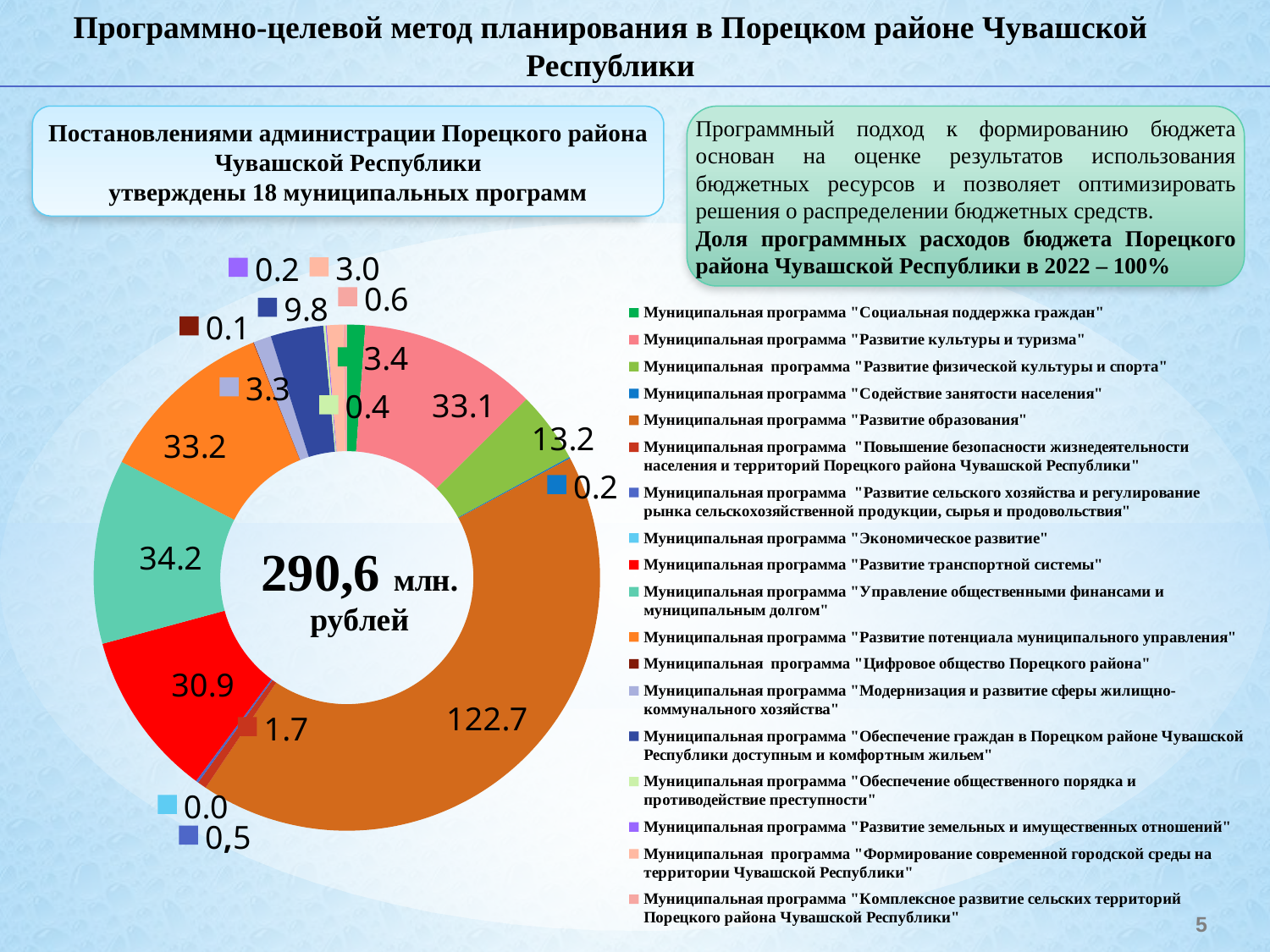
What is the value shown for the programme "Обеспечение граждан в Порецком районе Чувашской Республики доступным и комфортным жильем" (navy segment)? 9.8 How many municipal programmes are listed in the chart legend? 18 What is the value shown for the programme "Развитие транспортной системы" (red segment)? 30.9 What is the value shown for the programme "Развитие культуры и туризма" (pink segment)? 33.1 What kind of chart is shown on the slide? Doughnut (pie) chart What is the difference between the values for "Развитие образования" (122.7) and "Управление общественными финансами и муниципальным долгом" (34.2)? 88.5 What is the value shown for the programme "Управление общественными финансами и муниципальным долгом" (teal segment)? 34.2 What is the value shown for the programme "Развитие физической культуры и спорта" (light green segment)? 13.2 What total amount is printed in the centre of the doughnut chart? 290,6 млн. рублей What is the value shown for the programme "Развитие образования"? 122.7 Which is larger: the value for "Развитие транспортной системы" or the value for "Развитие потенциала муниципального управления"? Развитие потенциала муниципального управления (33.2) Which municipal programme has the largest value in the chart? Муниципальная программа "Развитие образования"